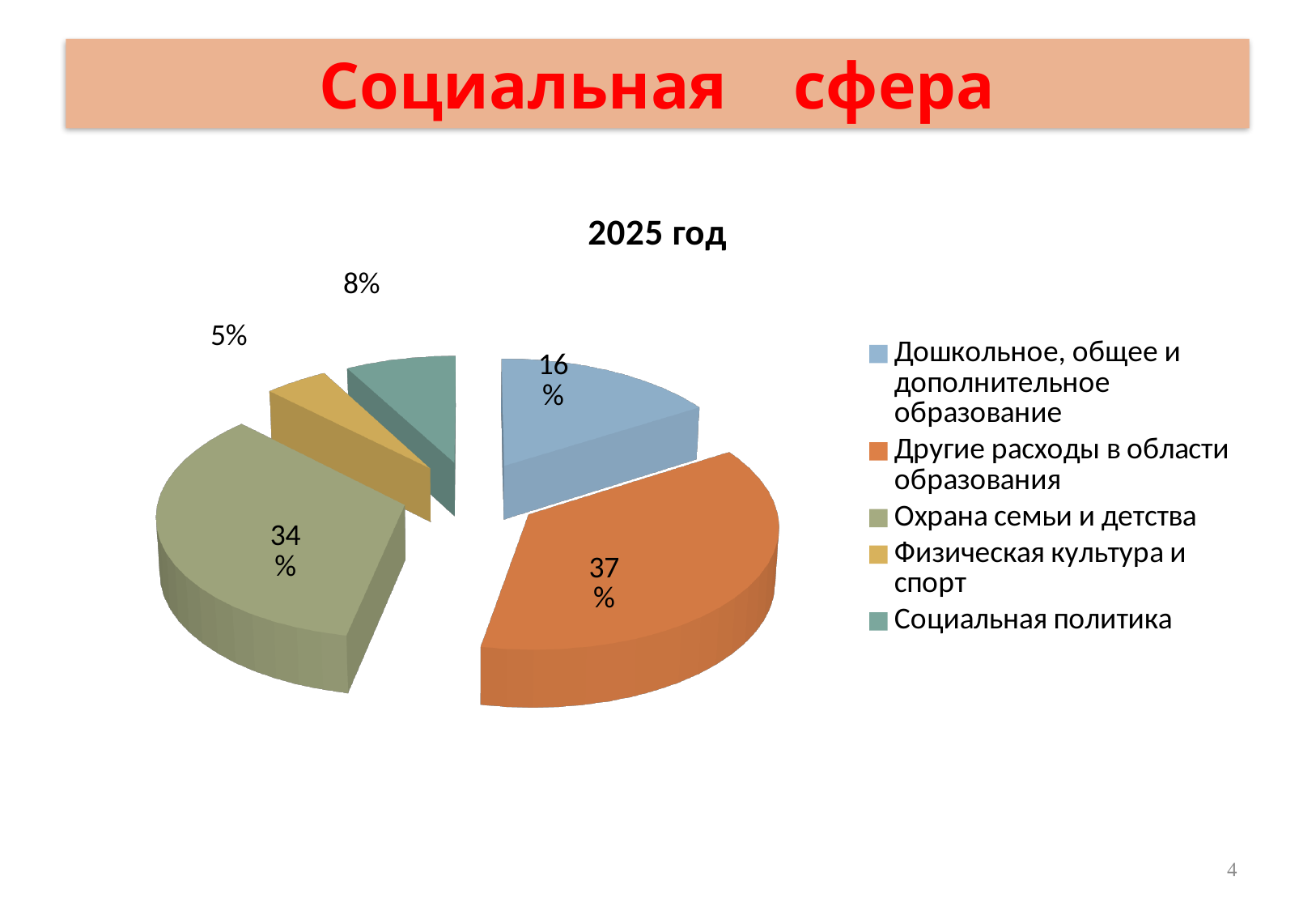
What is the title of the chart? 2025 год Which category has the smallest share of the pie? Физическая культура и спорт What share of the pie is "Другие расходы в области образования"? 37% What kind of chart is shown on the slide? pie chart What share of the pie is "Физическая культура и спорт"? 5% What share of the pie is "Социальная политика"? 8% What is the difference in percentage points between "Другие расходы в области образования" and "Охрана семьи и детства"? 3 percentage points How many slices does the pie chart have? 5 Which is larger: the share for "Социальная политика" or the share for "Физическая культура и спорт"? Социальная политика Which category has the largest share of the pie? Другие расходы в области образования